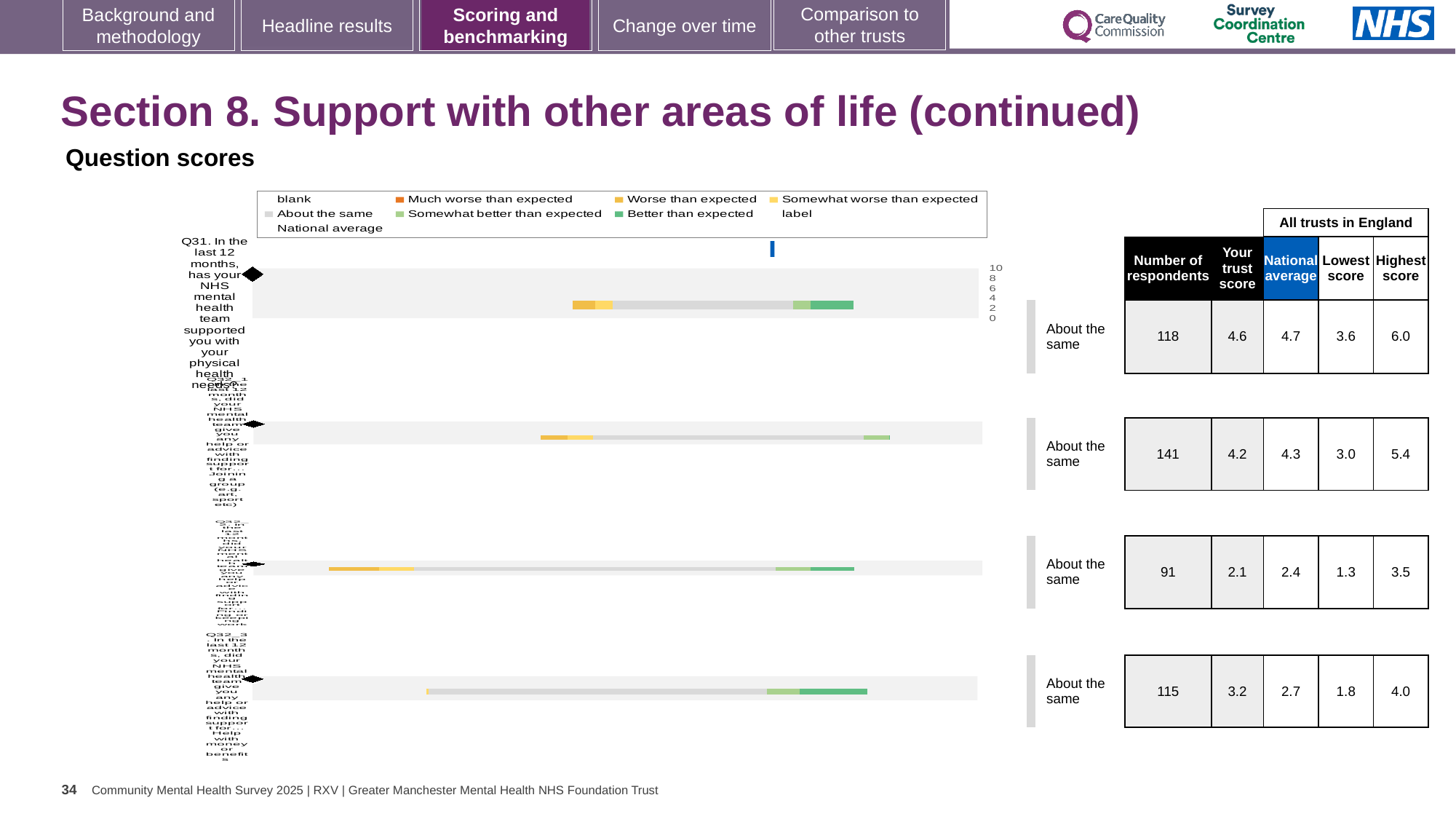
What is the difference between the highest score (6.0) and the lowest score (3.6) for Q31? 2.4 What benchmark category is shown for Q31 (support with physical health needs)? About the same What is the national average for Q31 (support with physical health needs)? 4.7 What is the trust score for Q31 (support with physical health needs)? 4.6 How many entries does the chart legend list? 9 How many questions (bars) are plotted in the question scores chart? 4 What is the trust score for Q32_3 (help with money or benefits)? 3.2 For Q32_3 (help with money or benefits), which is larger: the trust score or the national average? Your trust score What is the highest score among all trusts in England for Q31? 6.0 For Q31, which is larger: the trust score or the national average? National average What is the number of respondents for Q31 (support with physical health needs)? 118 What kind of chart is used to show the question scores on this slide? bar chart